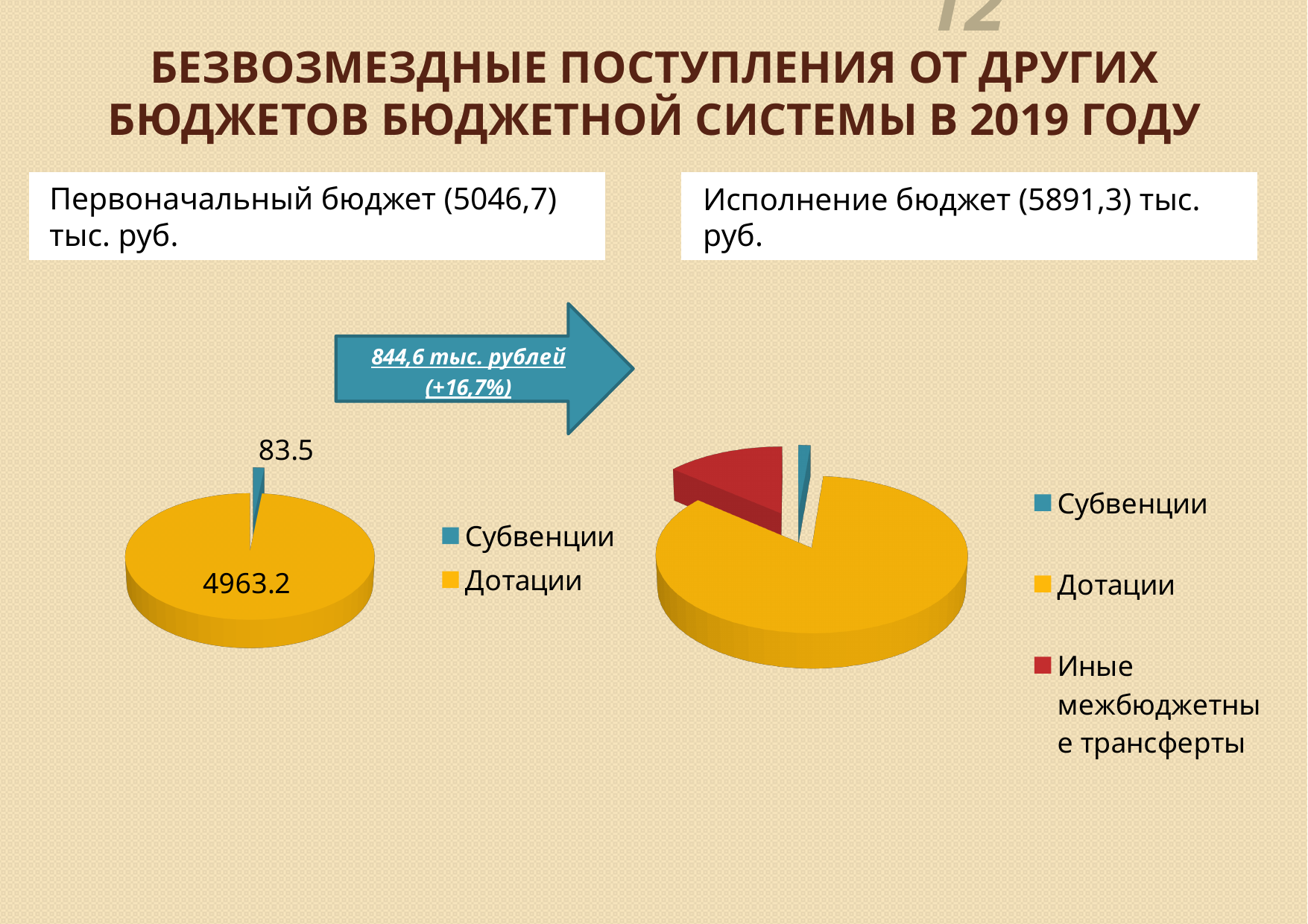
In the right pie chart (Исполнение бюджет), which category has the smallest slice? Субвенции What type of chart is used on the left side of the slide? Pie chart In the right pie chart (Исполнение бюджет), how many slices are there? 3 In the right pie chart (Исполнение бюджет), which is larger: Дотации or Иные межбюджетные трансферты? Дотации In the right pie chart (Исполнение бюджет), which category has the largest slice? Дотации In the left pie chart (Первоначальный бюджет), what is the value for Дотации? 4963.2 In the left pie chart (Первоначальный бюджет), how many categories does the legend list? 2 In the right pie chart (Исполнение бюджет), what colour is the slice for Иные межбюджетные трансферты? Red In the left pie chart (Первоначальный бюджет), which category has the smallest value? Субвенции In the left pie chart (Первоначальный бюджет), what is the difference between the values for Дотации and Субвенции? 4879.7 In the left pie chart (Первоначальный бюджет), what is the value for Субвенции? 83.5 In the left pie chart (Первоначальный бюджет), which category has the largest value? Дотации